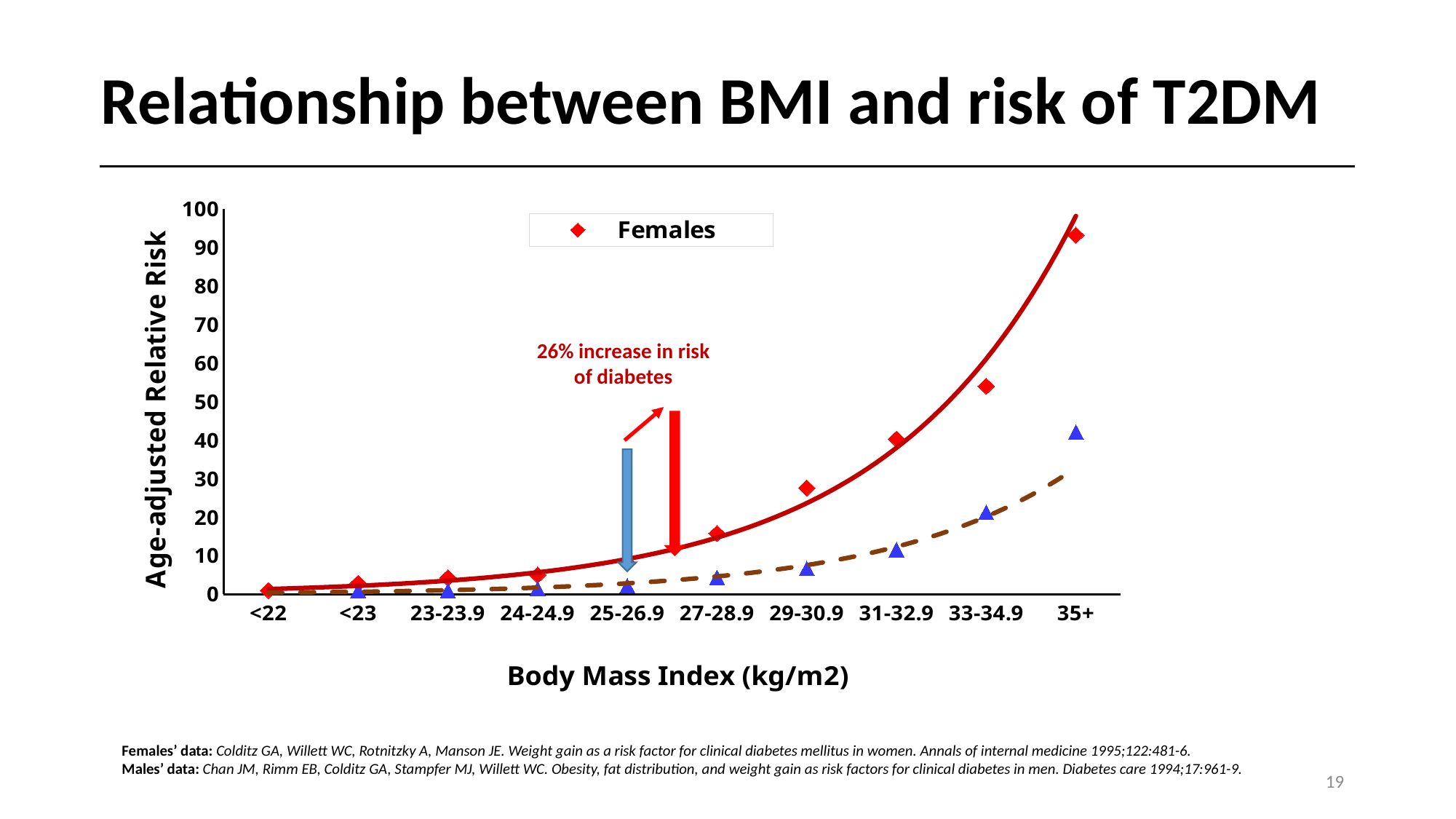
Is the blue-triangle series value for the 33-34.9 category greater or less than 30? less How many series does the legend list? 1 How many BMI categories are shown on the x axis? 10 Is the Females value for the 35+ category greater or less than 80? greater At the 35+ category, which is larger: the Females (red diamond) value or the blue-triangle series value? Females What kind of chart is shown on the slide? Scatter chart What is the title of the x axis? Body Mass Index (kg/m2) For which BMI category is the Females relative risk lowest? <22 Does the Females relative risk rise or fall as BMI increases along the x axis? Rise Is the Females value for the 33-34.9 category greater or less than 50? greater For which BMI category is the Females relative risk highest? 35+ Which series is named in the legend? Females